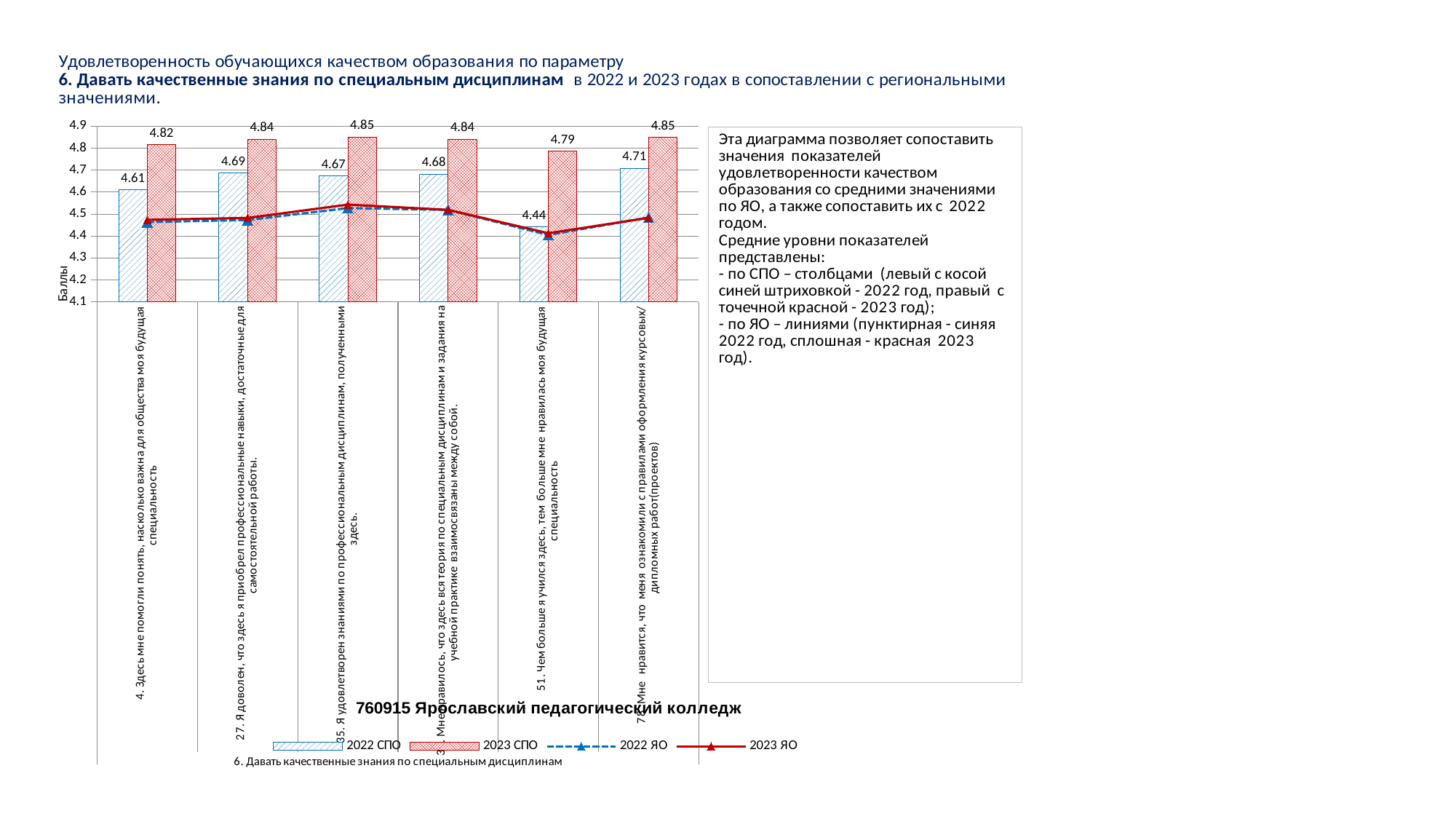
How many categories are shown on the x axis of the chart? 6 What is the 2022 СПО value for the category "27. Я доволен, что здесь я приобрел профессиональные навыки, достаточные для самостоятельной работы"? 4.69 Which is larger for the category "35. Я удовлетворен знаниями по профессиональным дисциплинам, полученными здесь": the 2022 СПО value or the 2023 СПО value? 2023 СПО What is the 2022 СПО value for the category "51. Чем больше я учился здесь, тем больше мне нравилась моя будущая специальность"? 4.44 What kind of chart is shown on the slide? Combined bar and line chart What is the difference between the 2023 СПО and 2022 СПО values for the category "4. Здесь мне помогли понять, насколько важна для общества моя будущая специальность"? 0.21 Which category has the lowest 2022 СПО value? 51. Чем больше я учился здесь, тем больше мне нравилась моя будущая специальность What is the 2023 СПО value for the category "51. Чем больше я учился здесь, тем больше мне нравилась моя будущая специальность"? 4.79 Which category has the lowest 2023 СПО value? 51. Чем больше я учился здесь, тем больше мне нравилась моя будущая специальность How many series does the chart legend list? 4 What is the 2023 СПО value for the category "4. Здесь мне помогли понять, насколько важна для общества моя будущая специальность"? 4.82 Is the 2023 ЯО value for the category "51. Чем больше я учился здесь, тем больше мне нравилась моя будущая специальность" greater or less than 4.5? less